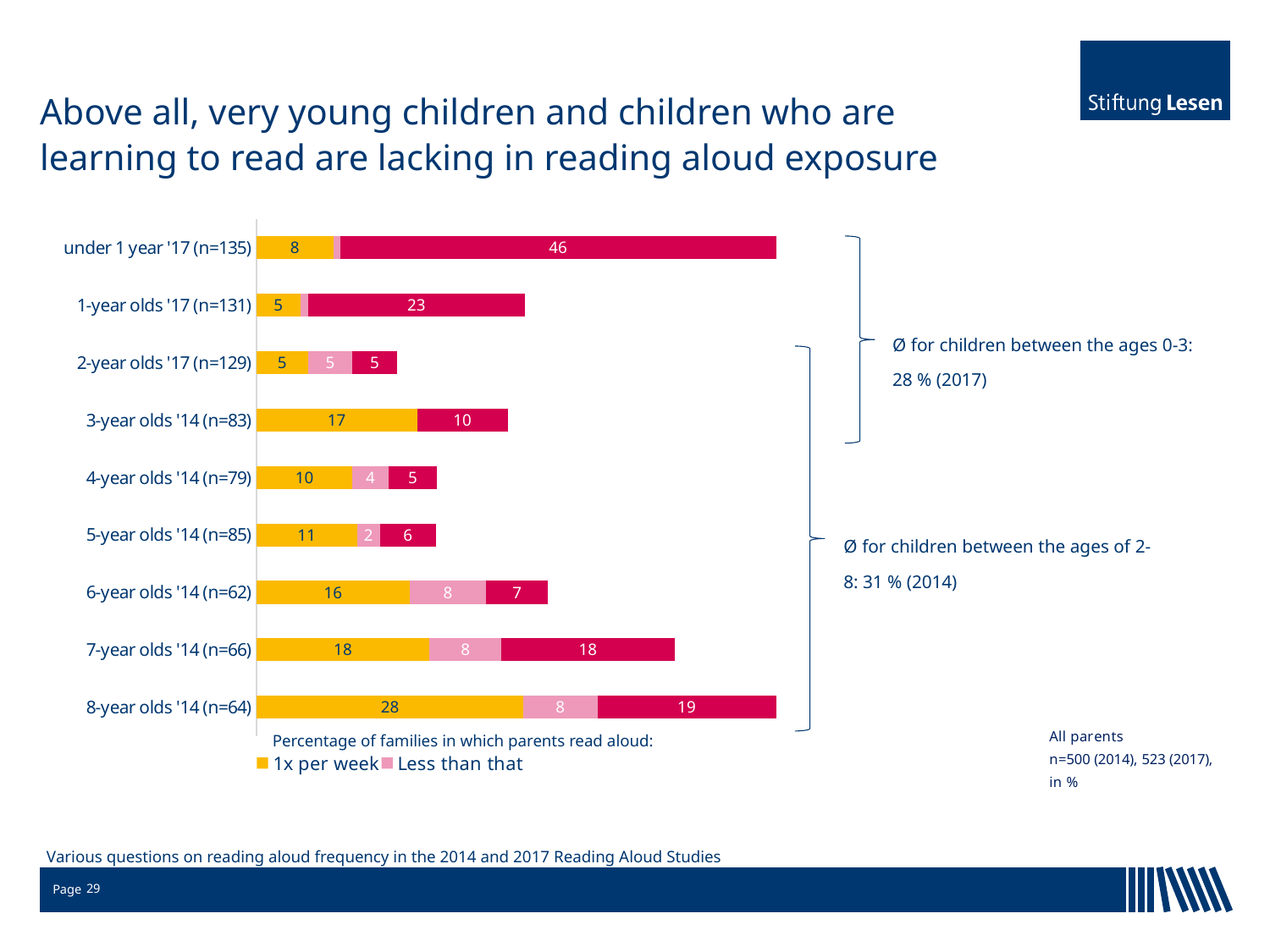
What is the '1x per week' value for 8-year olds '14 (n=64)? 28 Which is larger, the '1x per week' value for 7-year olds '14 or for 6-year olds '14? 7-year olds '14 What is the total of the stacked bar for 6-year olds '14 (n=62)? 31 What kind of chart is shown on the slide? Stacked bar chart What is the '1x per week' value for 3-year olds '14 (n=83)? 17 What is the 'Less than that' value for 4-year olds '14 (n=79)? 4 What is the total of the stacked bar for 8-year olds '14 (n=64)? 55 How many series does the chart's legend list? 2 What is the 'Less than that' value for 5-year olds '14 (n=85)? 2 Which age group has the highest '1x per week' value? 8-year olds '14 (n=64) How many age-group categories are plotted in the chart? 9 What is the difference between the '1x per week' values for 8-year olds '14 and 7-year olds '14? 10